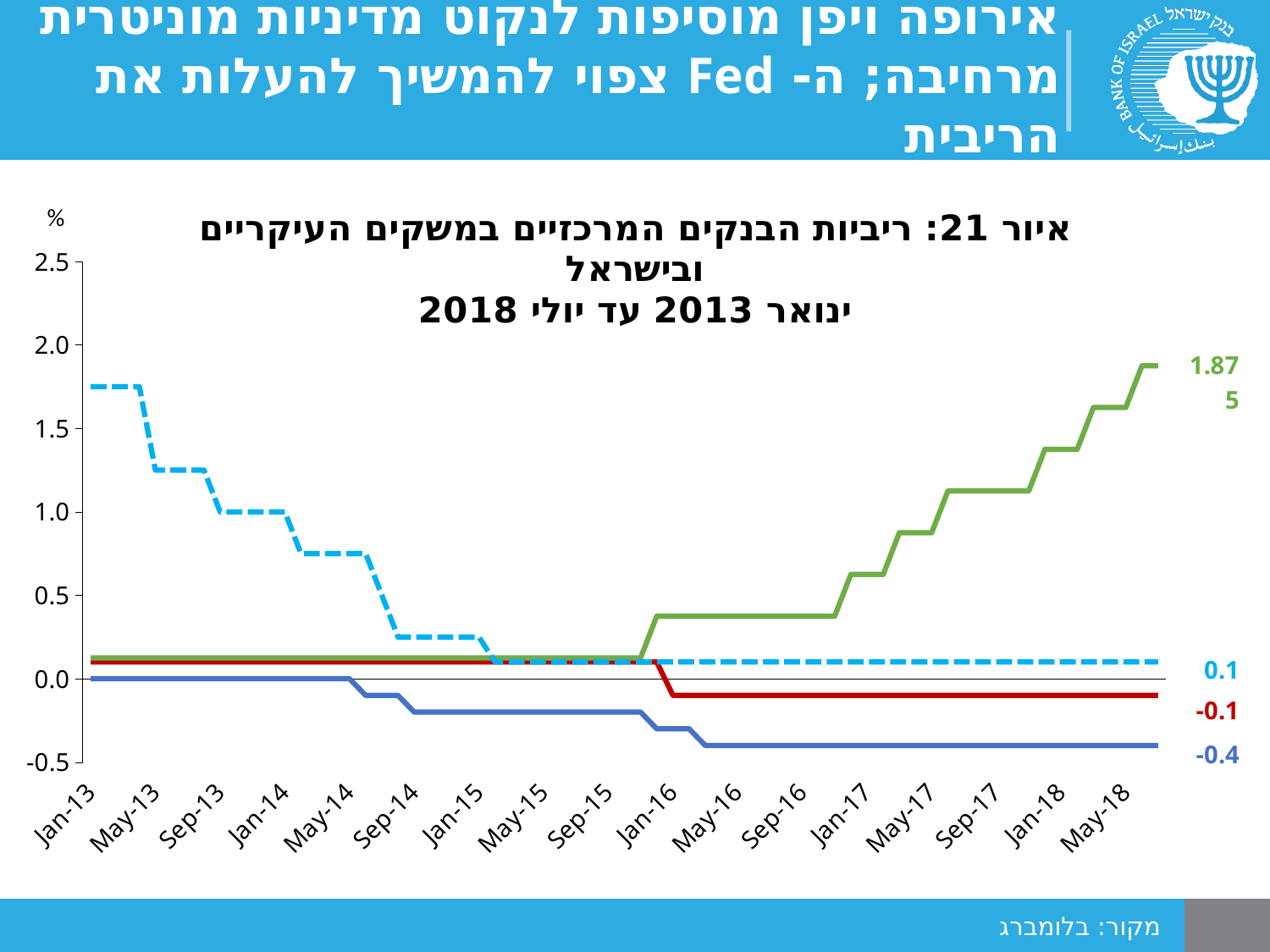
What is the final value labelled at the end of the red line? -0.1 How many lines are plotted on the chart? 4 Which line has the lowest value at the end of the period (May-18)? The dark-blue line Which line has the highest value at the end of the period (May-18)? The green line What is the final value labelled at the end of the dashed light-blue line? 0.1 What is the difference between the final values of the green line (1.875) and the dashed light-blue line (0.1)? 1.775 What is the final value labelled at the end of the green line? 1.875 Is the value of the dashed light-blue line at Jan-13 greater or less than 1.5? greater What is the final value labelled at the end of the dark-blue line? -0.4 What kind of chart is shown on the slide? Line chart What is the unit shown on the vertical axis of the chart? % Does the green line rise or fall between Jan-16 and May-18? Rises